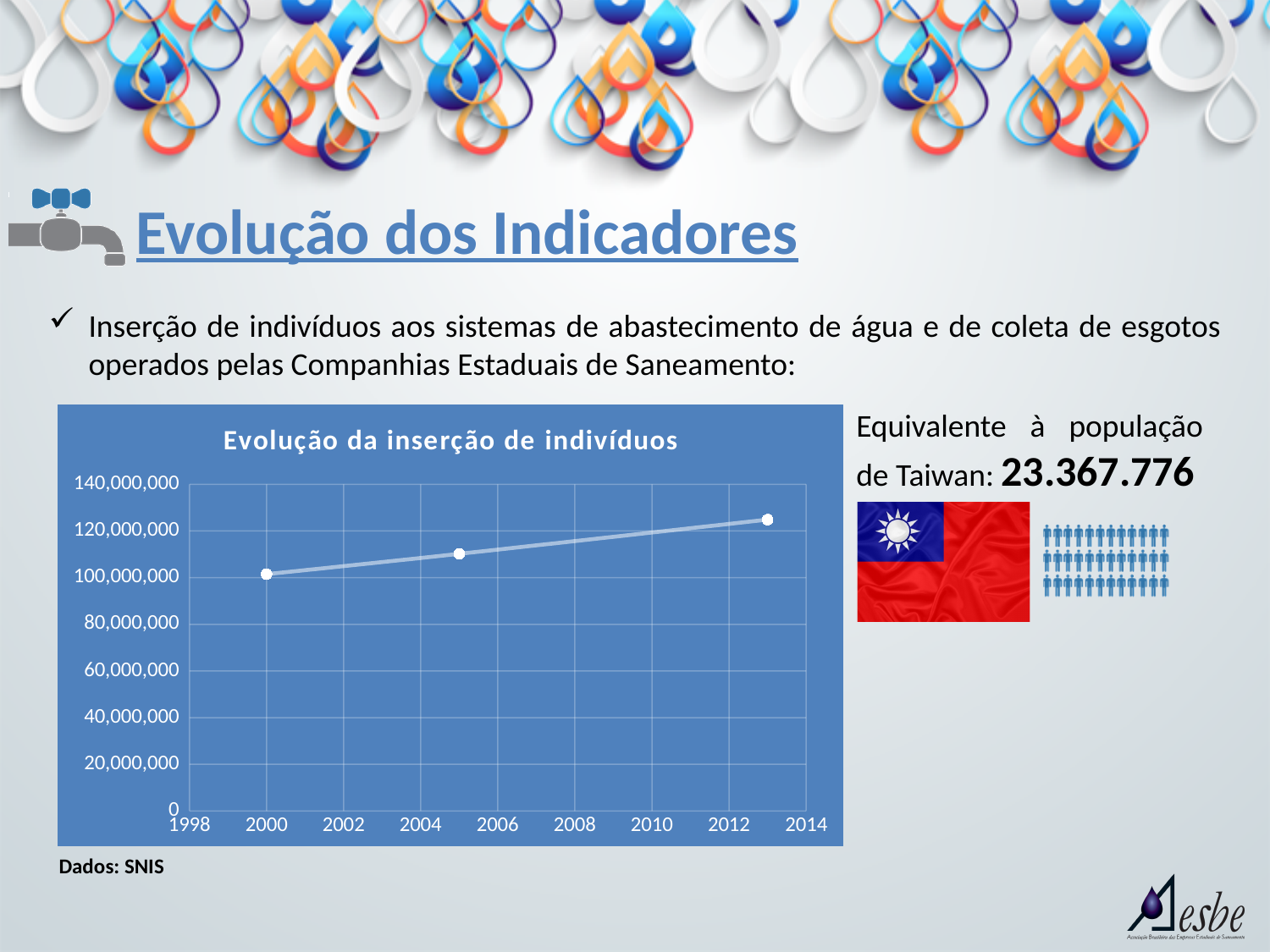
Is the value of the middle point, around 2005, greater or less than 100,000,000? greater Is the value of the middle point, around 2005, greater or less than 120,000,000? less Which is larger: the value around 2005 or the value around 2013? the value around 2013 What is the highest tick label shown on the y axis? 140,000,000 What kind of chart is shown on the slide? line chart Which point has the lowest value on the line? the first point, around 2000 Which point has the highest value: the one around 2000 or the one around 2013? the one around 2013 Is the value of the first (leftmost) point, around 2000, greater or less than 120,000,000? less What is the title of the chart? Evolução da inserção de indivíduos How many data points are plotted on the line? 3 Do the values rise or fall from left to right along the x axis? rise